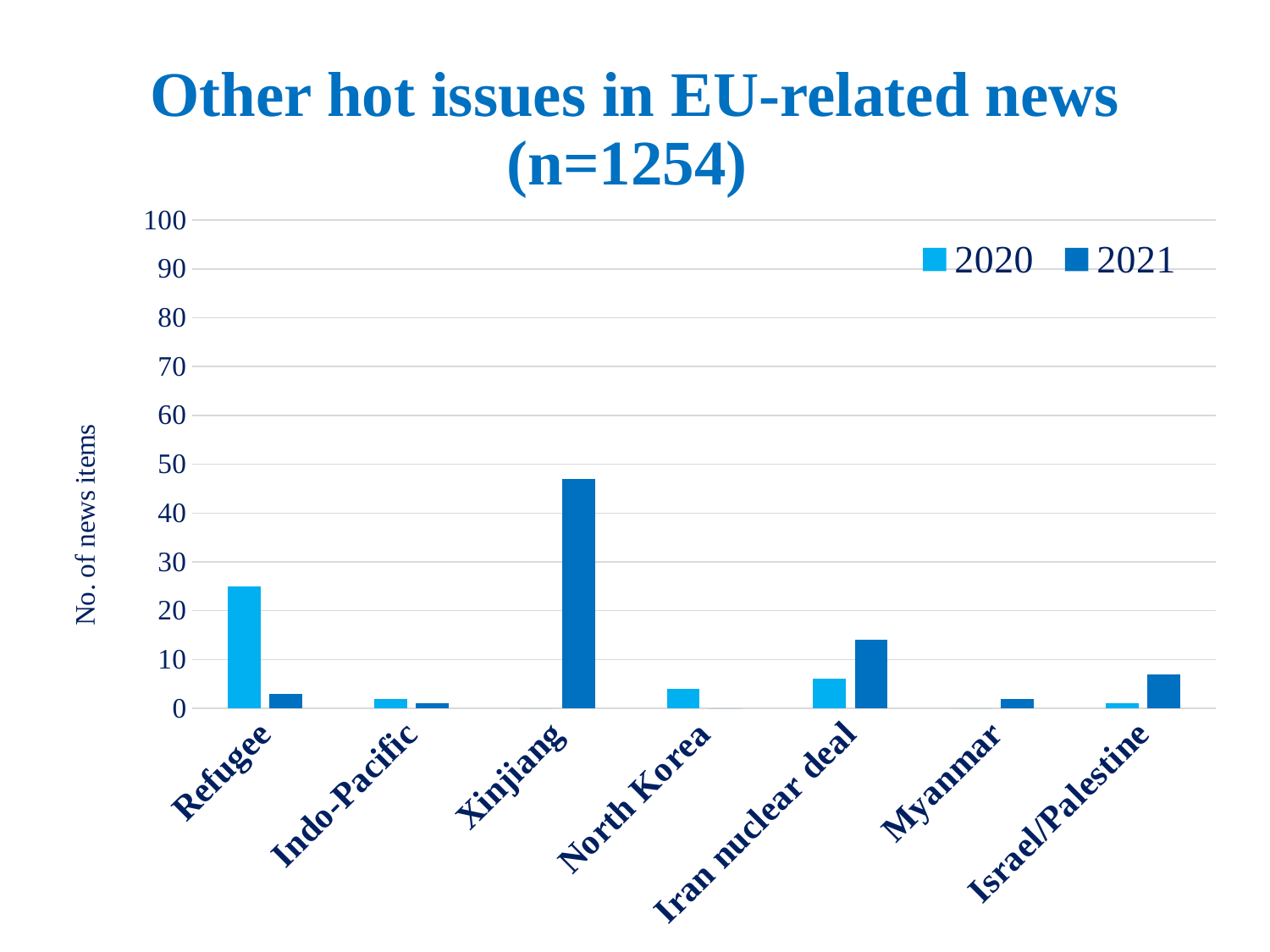
How many series does the legend list? 2 Which issue has the highest number of news items in 2021? Xinjiang Which issue has the highest number of news items in 2020? Refugee Is the 2021 value for Iran nuclear deal greater or less than 10? greater What kind of chart is shown on the slide? bar chart Is the 2021 value for Xinjiang greater or less than 40? greater Is the 2020 value for Refugee greater or less than 20? greater What is the label of the y axis? No. of news items For Iran nuclear deal, which year has more news items, 2020 or 2021? 2021 How many issue categories are shown on the x axis? 7 For Refugee, which year has more news items, 2020 or 2021? 2020